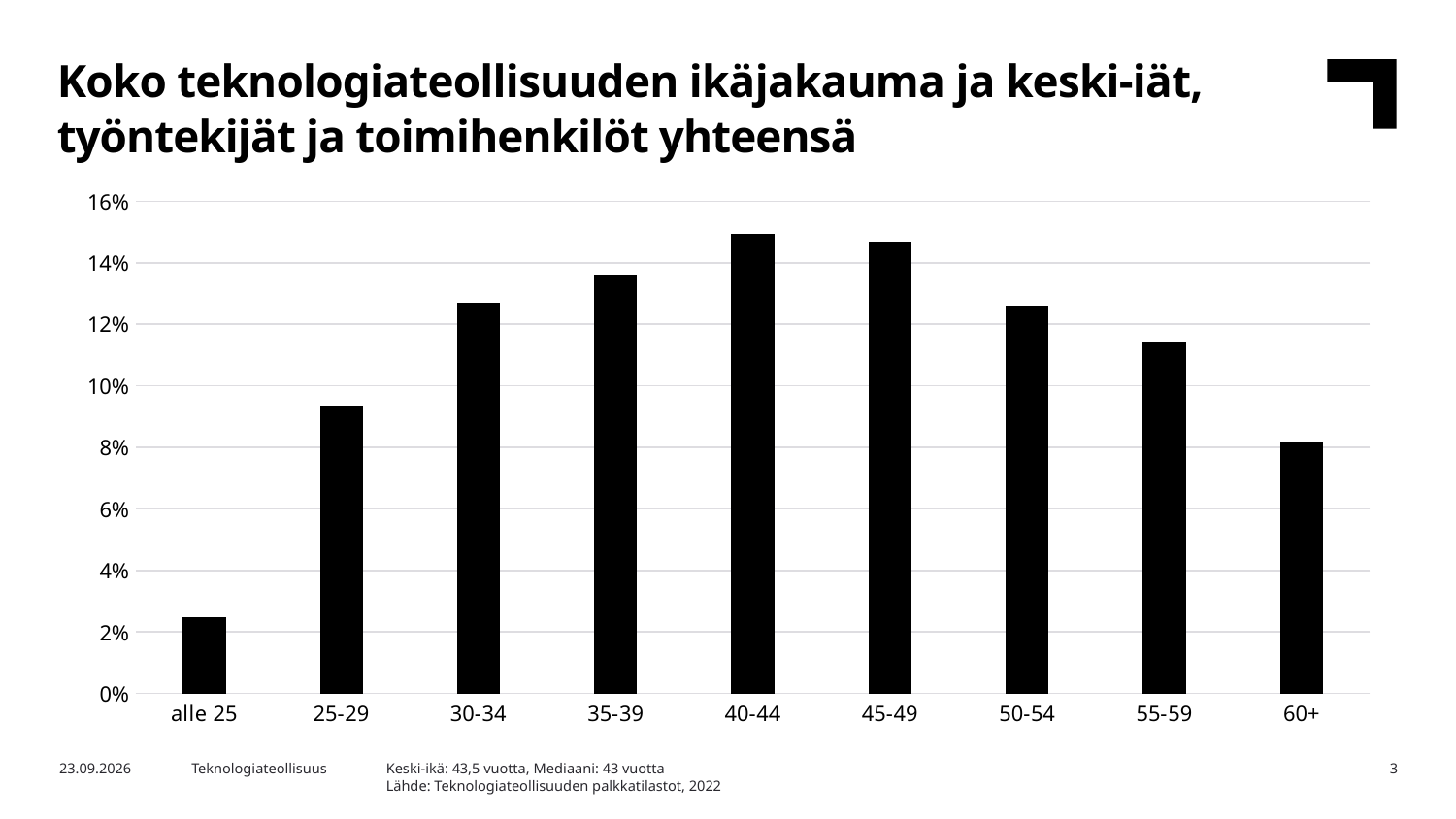
Is the value for 40-44 greater or less than 14%? greater How many age categories are shown on the x axis? 9 According to the footer text, what is the mean age (keski-ikä)? 43,5 vuotta Which age category has the lowest value? alle 25 Do the values rise or fall from alle 25 to 40-44? rise Is the value for 55-59 greater or less than 10%? greater Is the value for 25-29 greater or less than 10%? less What kind of chart is shown on the slide? bar chart Which is larger, the value for 30-34 or the value for 25-29? 30-34 Which is larger, the value for 55-59 or the value for 60+? 55-59